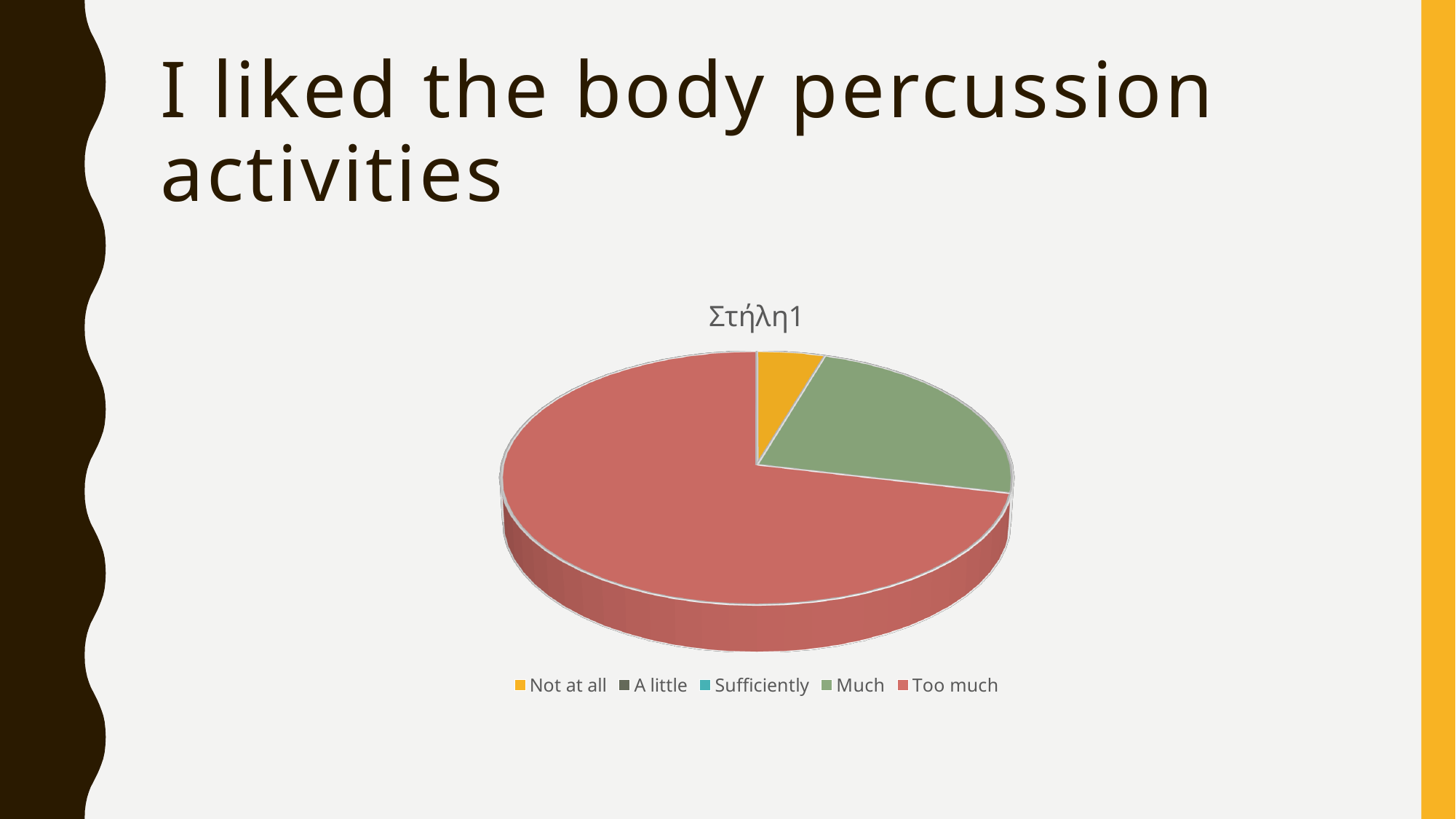
What colour is the slice for Too much? red Does the Too much slice take up more or less than half of the pie? more How many slices are visible in the pie? 3 Which of the visible slices is the smallest? Not at all Which slice is larger, Too much or Much? Too much Which category has the largest slice of the pie? Too much What is the title shown above the pie chart? Στήλη1 What kind of chart is shown on the slide? pie chart Which slice is larger, Much or Not at all? Much How many entries does the legend list? 5